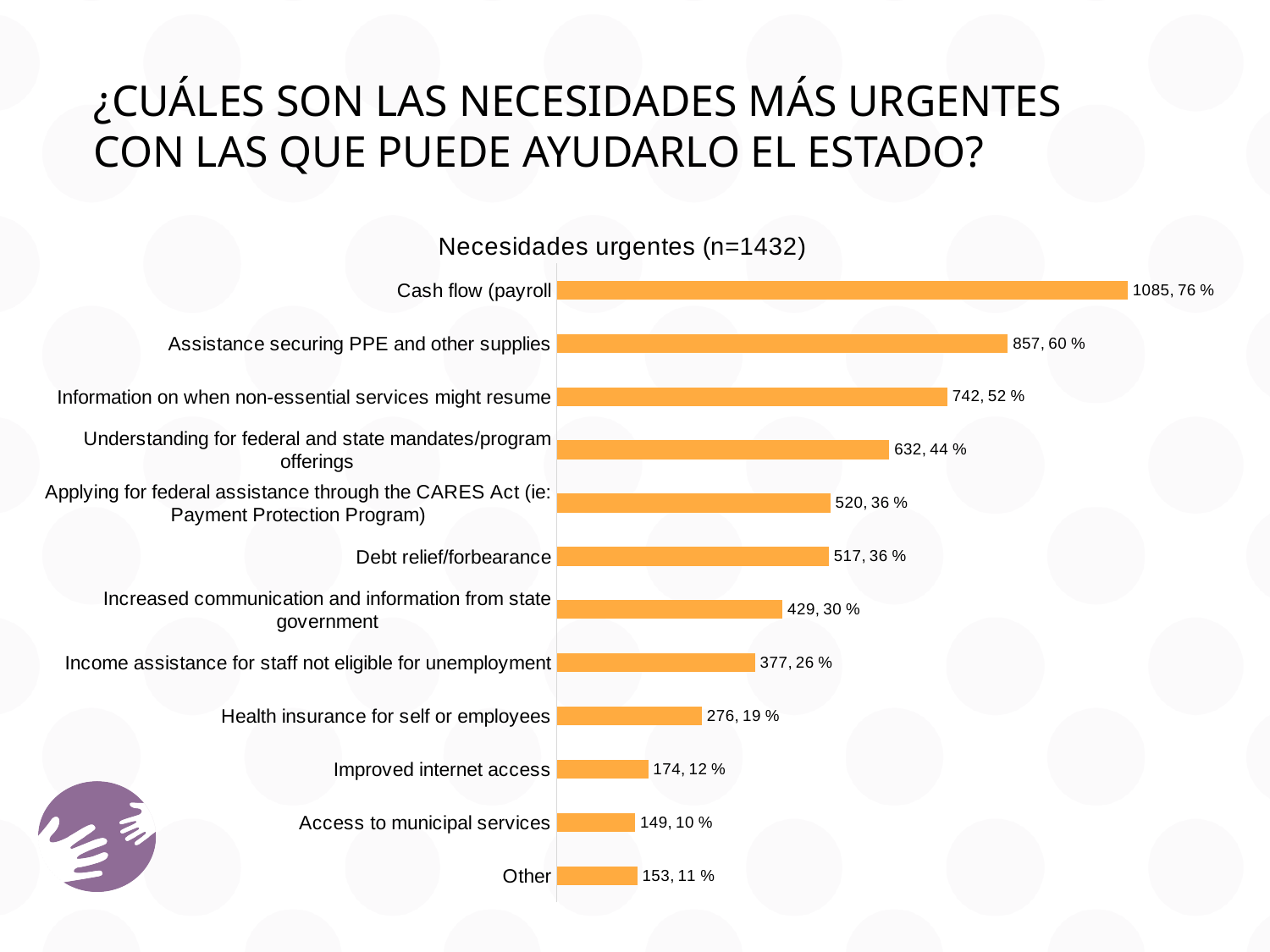
What is the difference in count between Other and Access to municipal services? 4 What is the value for Cash flow (payroll)? 1085, 76 % Which is larger, the value for Health insurance for self or employees or the value for Income assistance for staff not eligible for unemployment? Income assistance for staff not eligible for unemployment Which category has the highest value? Cash flow (payroll What kind of chart is shown on the slide? Bar chart Which category has the lowest value? Access to municipal services What is the title of the chart? Necesidades urgentes (n=1432) What is the value for Debt relief/forbearance? 517, 36 % What is the difference in count between Assistance securing PPE and other supplies and Information on when non-essential services might resume? 115 How many categories are shown in the chart? 12 What is the value for Improved internet access? 174, 12 % What colour are the bars in the chart? Orange